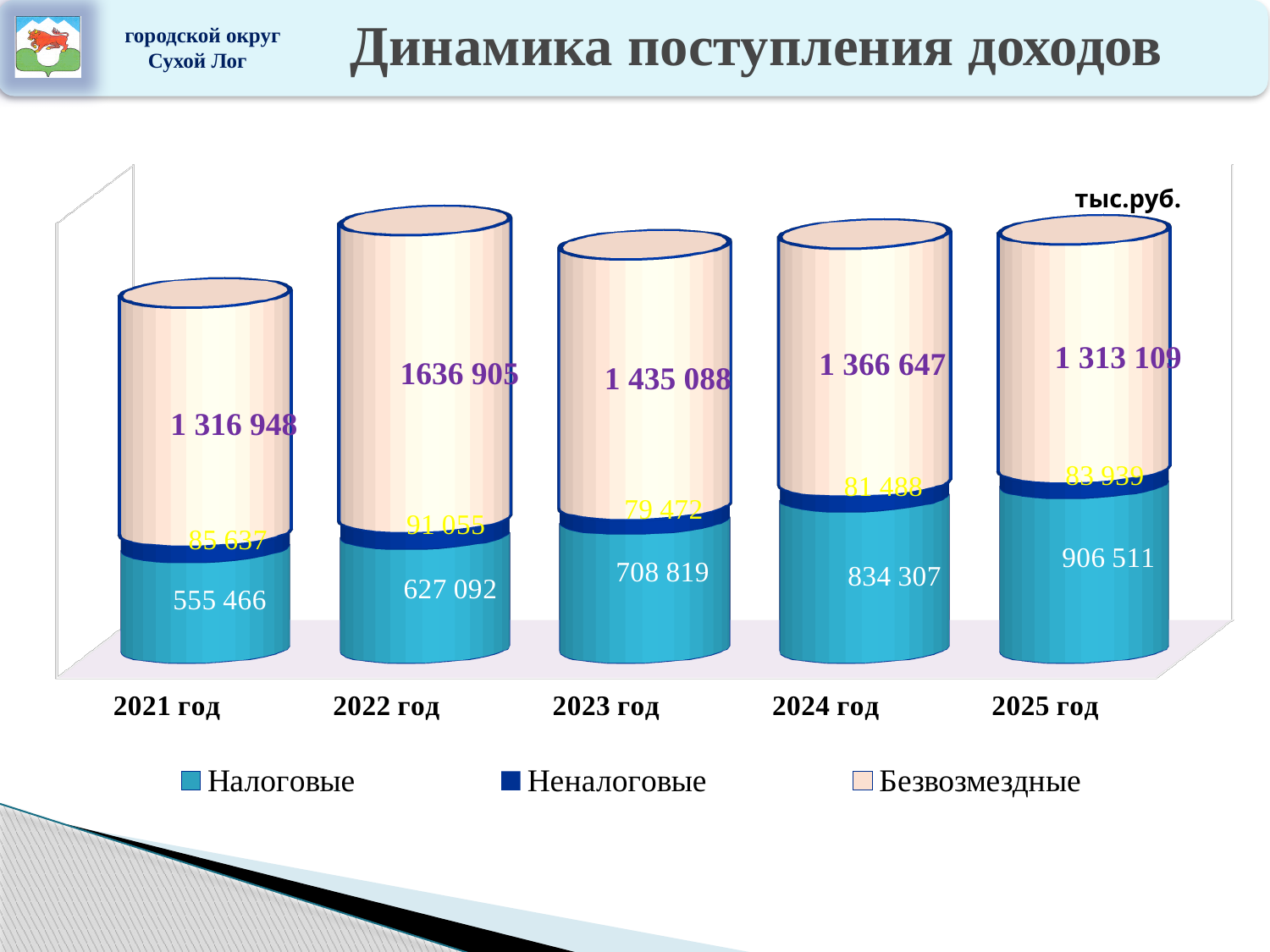
In which year is the Налоговые value highest? 2025 год What is the difference between the Налоговые values for 2025 год and 2021 год? 351 045 In which year is the Безвозмездные value highest? 2022 год What is the value of Налоговые for 2021 год? 555 466 What is the value of Безвозмездные for 2023 год? 1 435 088 In which year is the Неналоговые value lowest? 2023 год What is the total of the stacked bar for 2021 год? 1 958 051 What is the value of Налоговые for 2025 год? 906 511 Which is larger: Безвозмездные for 2024 год or Безвозмездные for 2025 год? 2024 год Does the Налоговые value rise or fall from 2021 год to 2025 год? rise How many series does the legend list? 3 What is the value of Неналоговые for 2024 год? 81 488